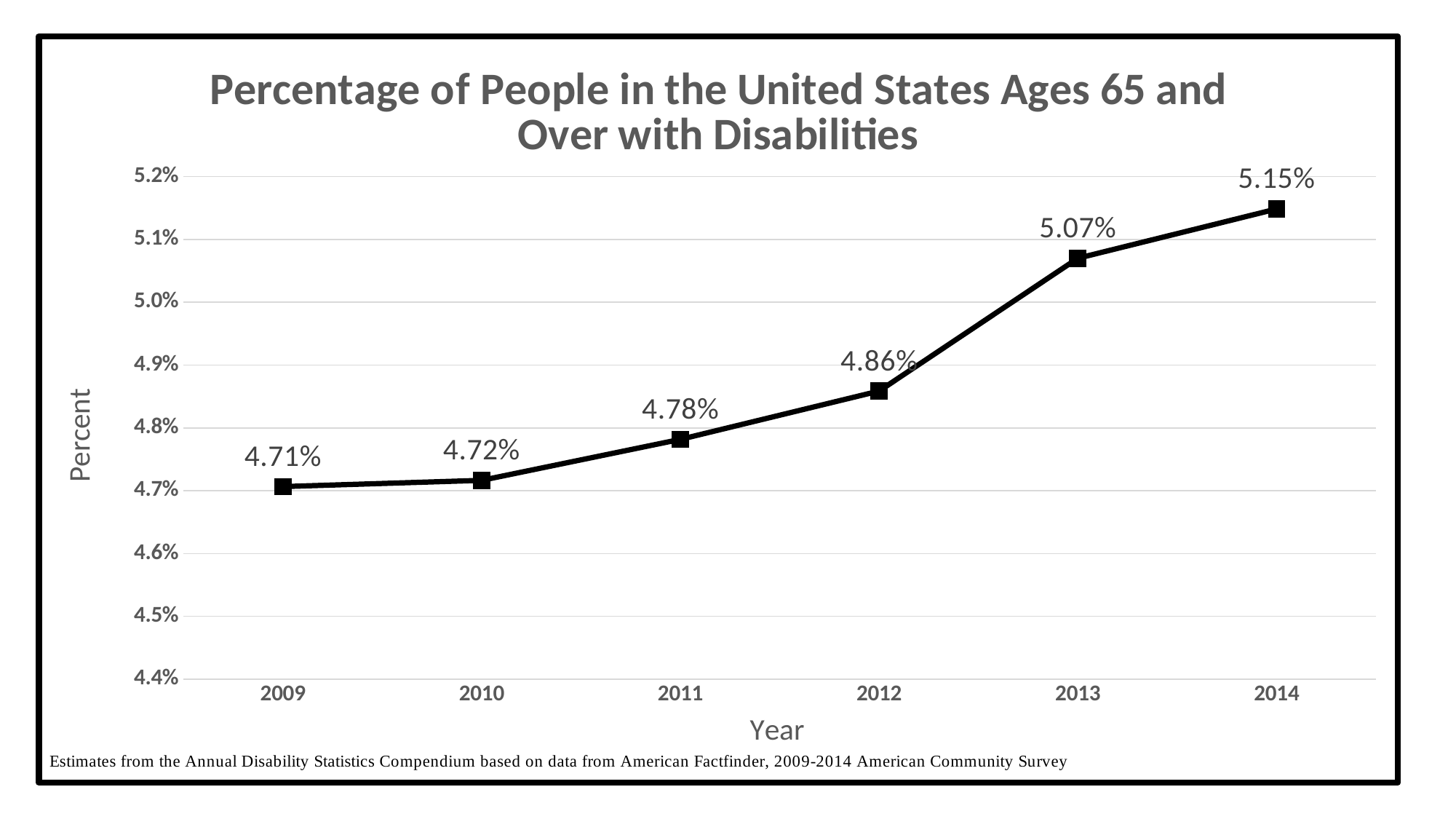
Is the value for 2013 greater or less than 5.0%? greater What is the value for 2009? 4.71% What is the value for 2014? 5.15% How many years are plotted on the chart? 6 Do the values rise or fall from 2009 to 2014? rise Which is larger, the value for 2011 or the value for 2013? 2013 Which year has the lowest value? 2009 What is the value for 2012? 4.86% What is the difference between the values for 2013 and 2012? 0.21% Which year has the highest value? 2014 What kind of chart is this? line chart What is the difference between the values for 2014 and 2009? 0.44%